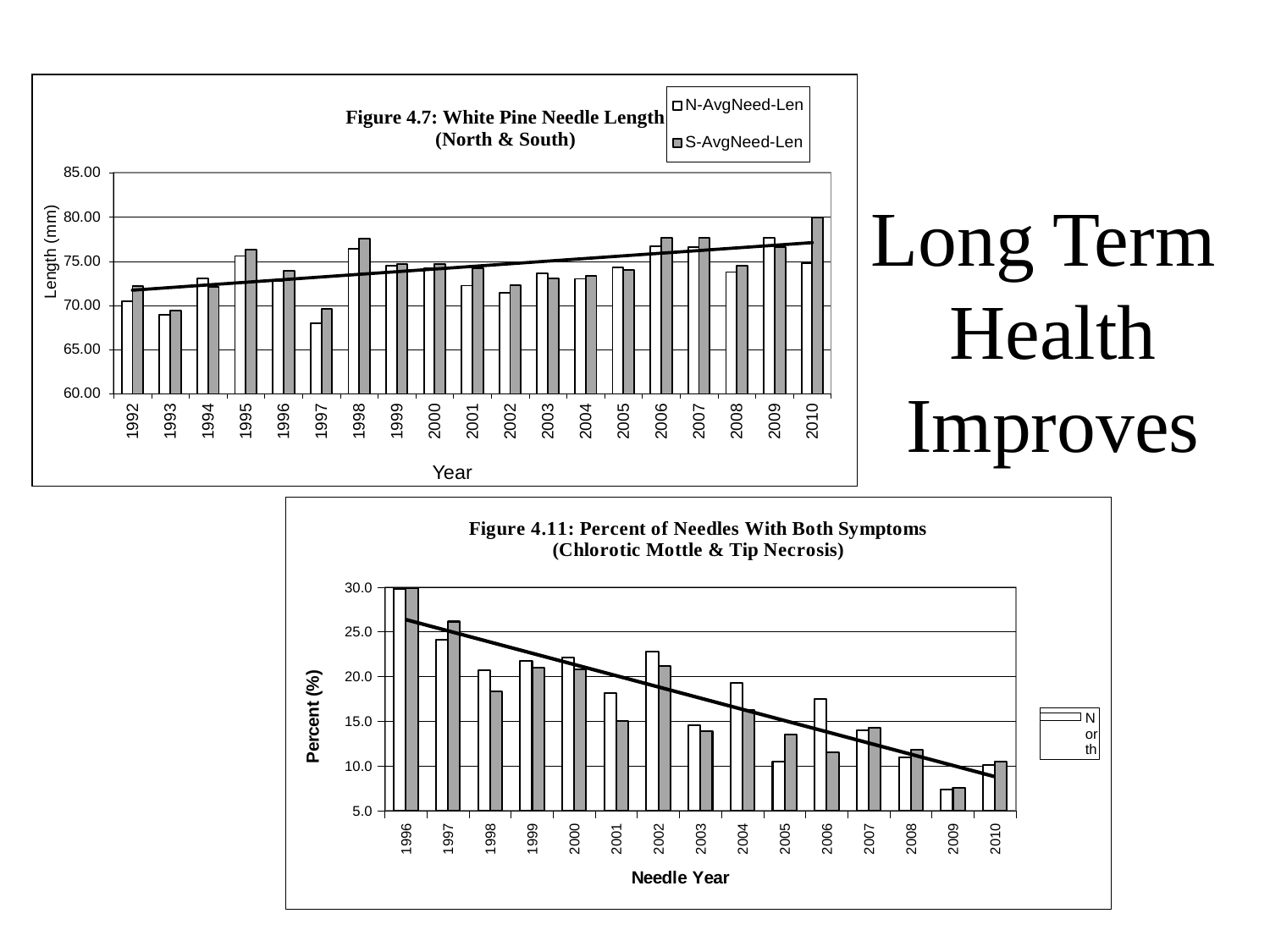
In Figure 4.7: White Pine Needle Length, does the trend line rise or fall from 1992 to 2010? rises In Figure 4.11: Percent of Needles With Both Symptoms, does the trend line rise or fall from 1996 to 2010? falls In Figure 4.11: Percent of Needles With Both Symptoms, which needle year has the highest white bar? 1996 In Figure 4.7: White Pine Needle Length, is the S-AvgNeed-Len value for 1998 greater or less than 75.00? greater In Figure 4.7: White Pine Needle Length, which year has the lowest N-AvgNeed-Len value? 1997 How many series does the legend of Figure 4.7: White Pine Needle Length list? 2 In Figure 4.11: Percent of Needles With Both Symptoms, how many needle years are shown on the x axis? 15 What type of chart is Figure 4.7: White Pine Needle Length (North & South)? bar chart In Figure 4.7: White Pine Needle Length, is the N-AvgNeed-Len value for 1997 greater or less than 70.00? less In Figure 4.7: White Pine Needle Length, which year has the highest S-AvgNeed-Len value? 2010 In Figure 4.7: White Pine Needle Length, how many years are shown on the x axis? 19 In Figure 4.11: Percent of Needles With Both Symptoms, is the white bar for 2009 greater or less than 10.0? less